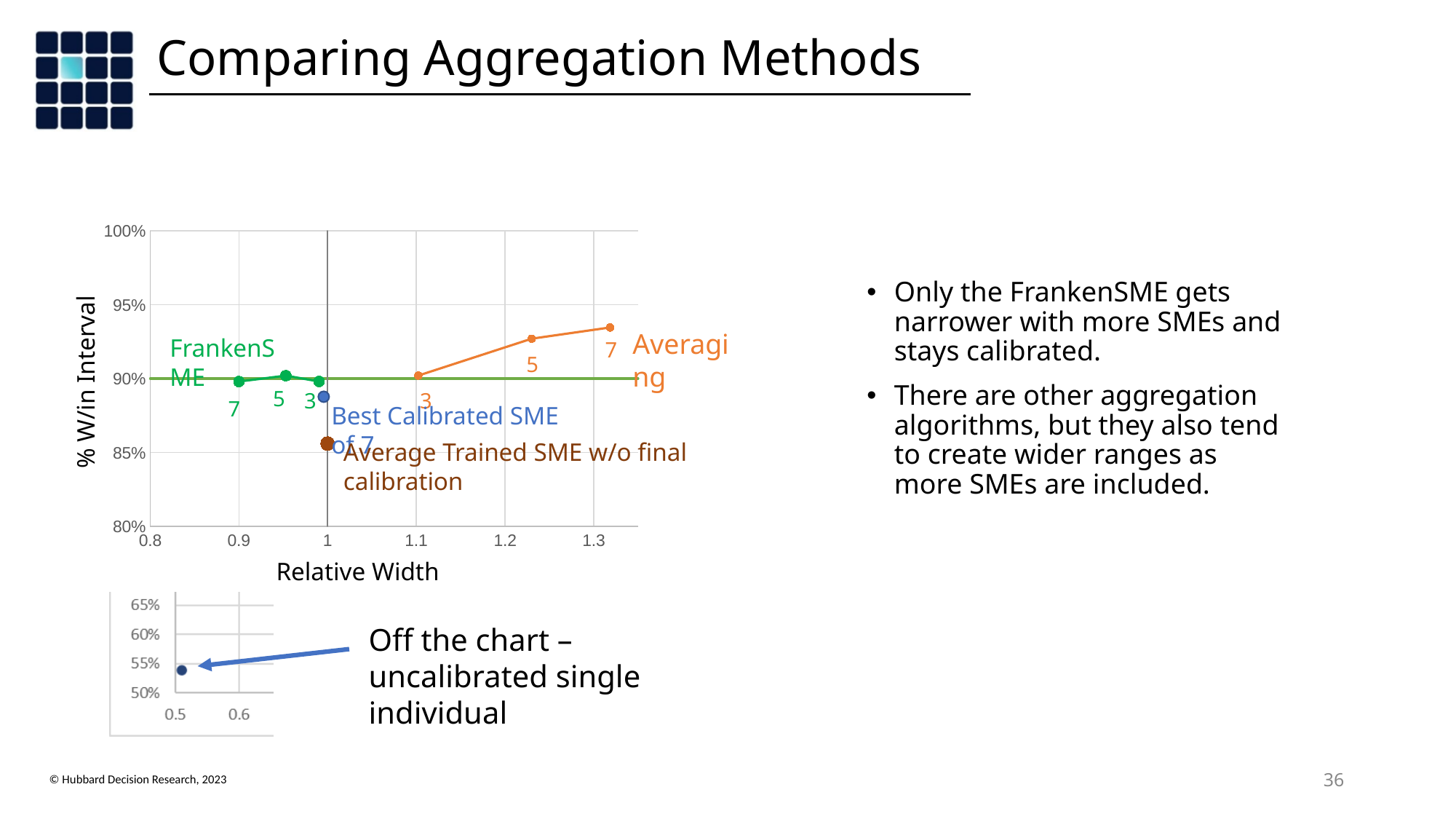
In the main chart, which has the higher % W/in Interval: the Averaging point labeled 7 or the FrankenSME point labeled 7? Averaging point labeled 7 What is the title of the y axis of the main chart? % W/in Interval In the main chart, is the Relative Width for the Averaging point labeled 7 greater or less than 1.2? greater In the main chart, does the Averaging series rise or fall as Relative Width increases? rise In the main chart, is the % W/in Interval for Average Trained SME w/o final calibration greater or less than 90%? less What is the title of the x axis of the main chart? Relative Width In the main chart, is the % W/in Interval for the Averaging point labeled 7 greater or less than 90%? greater In the main chart, which series has the lowest % W/in Interval? Average Trained SME w/o final calibration In the main chart, which series reaches the highest % W/in Interval? Averaging What kind of chart is the main chart on the slide? scatter chart with lines In the main chart, how many points are plotted for the Averaging series? 3 In the main chart, how many points are plotted for the FrankenSME series? 3